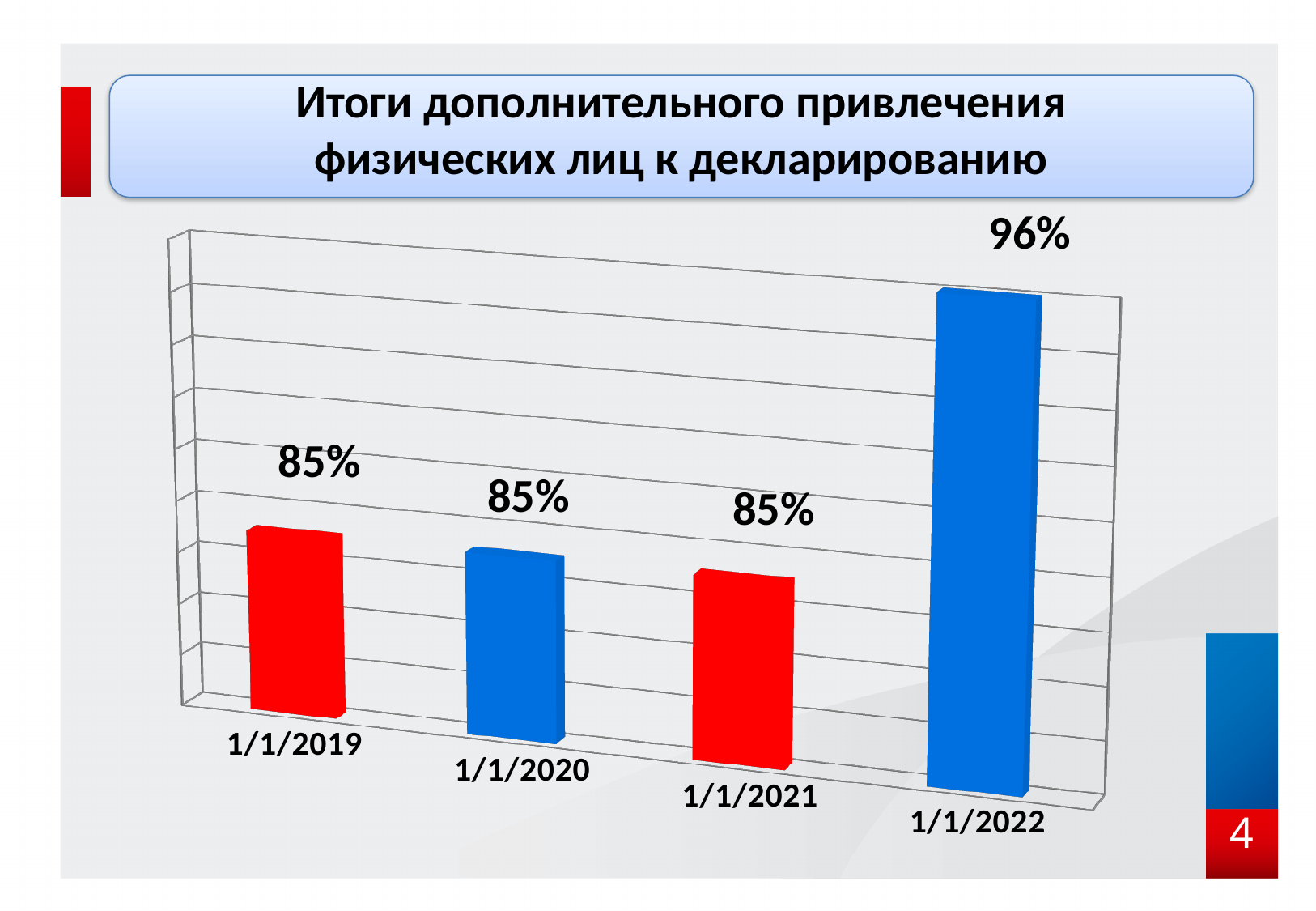
What is the value for 1/1/2021? 85% What is the difference between the values for 1/1/2022 and 1/1/2020? 11% What is the title of the chart? Итоги дополнительного привлечения физических лиц к декларированию How many categories are shown on the chart? 4 Do the values rise or fall from 1/1/2021 to 1/1/2022? rise What colour is the bar for 1/1/2020? blue Which category has the highest value? 1/1/2022 What kind of chart is shown on the slide? bar chart What is the value for 1/1/2019? 85% What is the value for 1/1/2022? 96% Which is larger, the value for 1/1/2022 or the value for 1/1/2019? 1/1/2022 How many categories have a value of 85%? 3